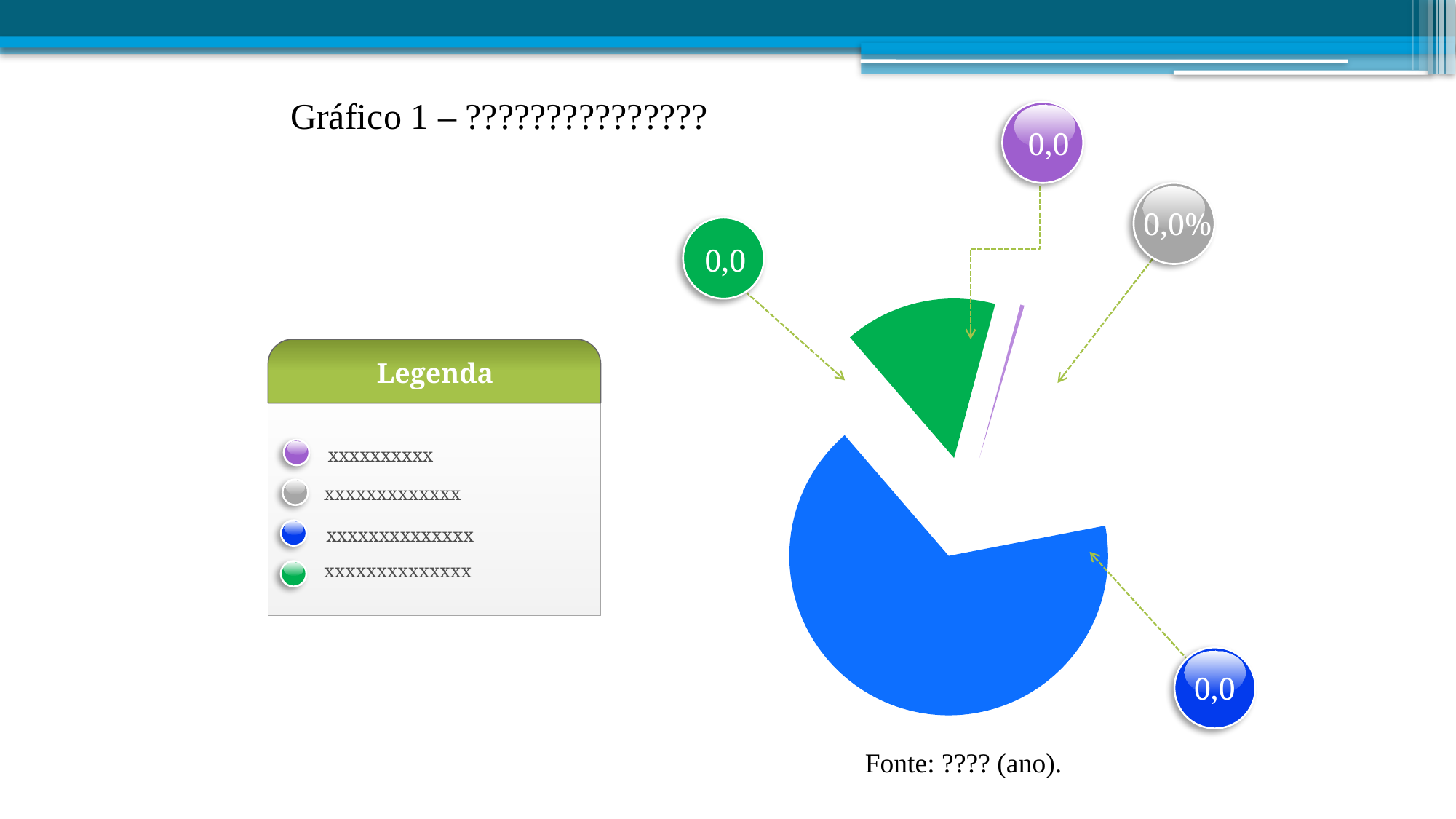
What is the heading of the legend box? Legenda Which is larger, the blue slice or the green slice? blue What value label is attached to the blue slice? 0,0 What kind of chart is shown on the slide? pie chart What value label is attached to the gray callout? 0,0% How many entries does the legend (Legenda) list? 4 Which is larger, the green slice or the purple slice? green Which colour slice is the largest in the pie chart? blue What is the title of the chart? Gráfico 1 – ??????????????